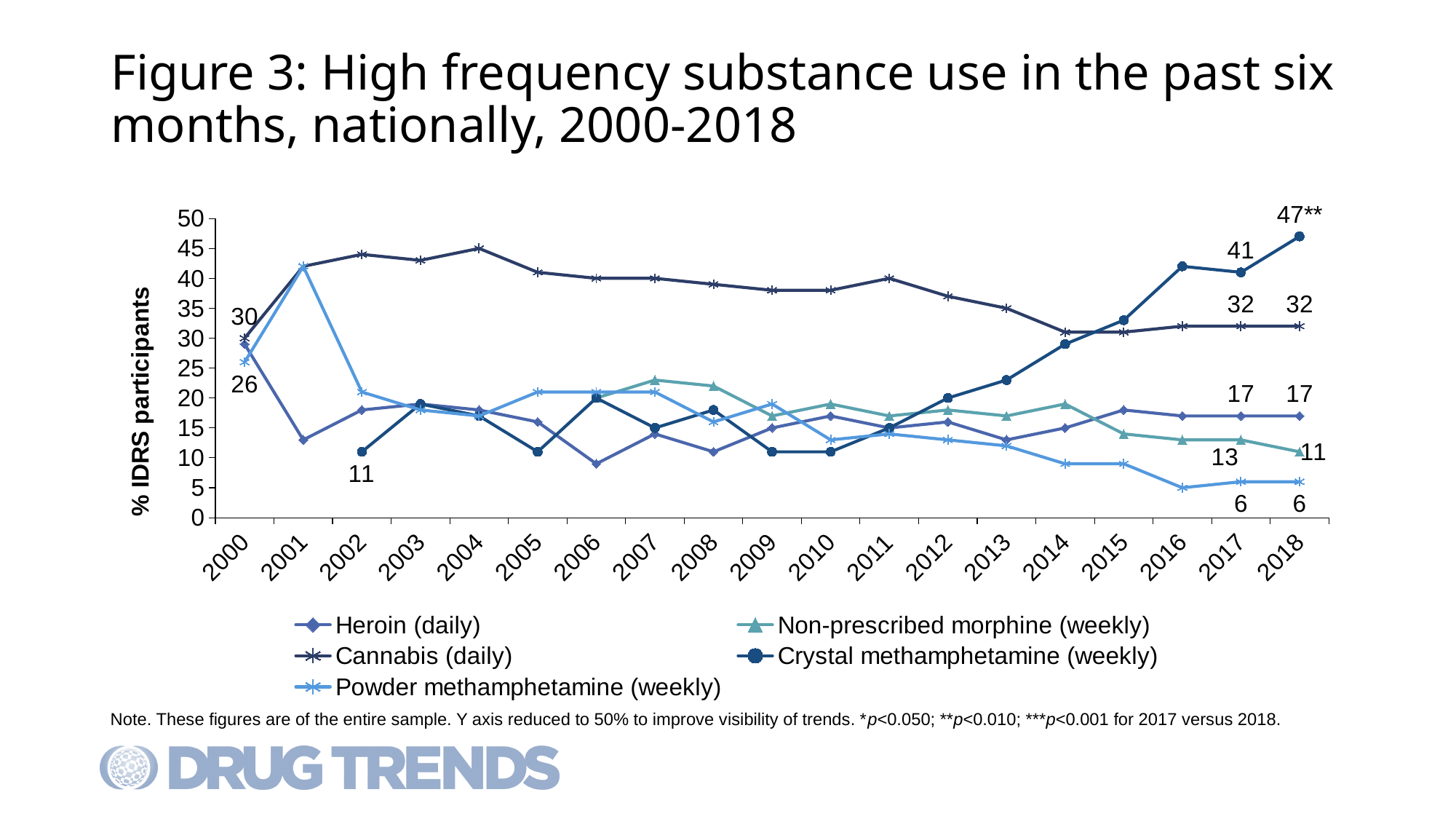
What is the value for Cannabis (daily) in 2000? 30 What kind of chart is shown on the slide? Line chart Which series has the highest value in 2018? Crystal methamphetamine (weekly) Does the Crystal methamphetamine (weekly) line rise or fall from 2010 to 2018? Rise How many years are plotted along the x axis? 19 Which series has the lowest value in 2018? Powder methamphetamine (weekly) What is the difference between Crystal methamphetamine (weekly) and Cannabis (daily) in 2018? 15 Is the value for Cannabis (daily) in 2004 greater or less than 40? greater What is the value for Crystal methamphetamine (weekly) in 2018? 47** What is the value for Crystal methamphetamine (weekly) in 2002? 11 How many series does the legend list? 5 By how much did Crystal methamphetamine (weekly) increase from 2017 to 2018? 6